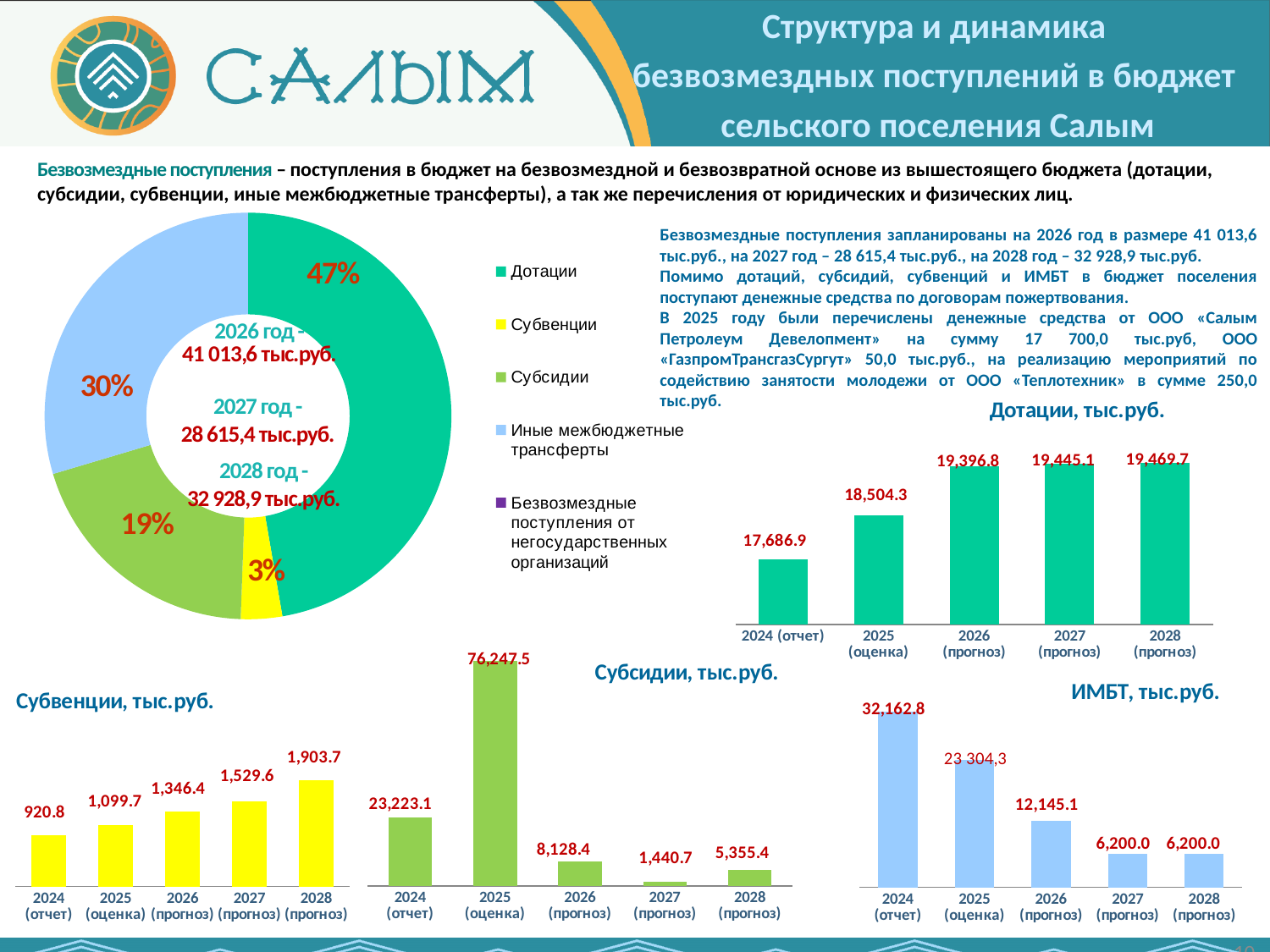
In the chart titled 'Субсидии, тыс.руб.', which year has the highest value? 2025 (оценка) What kind of chart is the one titled 'Субсидии, тыс.руб.'? bar chart In the chart titled 'Субвенции, тыс.руб.', which year has the highest value? 2028 (прогноз) In the chart titled 'Дотации, тыс.руб.', do the values rise or fall from 2024 to 2028? rise In the chart titled 'ИМБТ, тыс.руб.', do the values rise or fall from 2024 to 2028? fall In the chart titled 'Дотации, тыс.руб.', what is the value for 2025 (оценка)? 18,504.3 In the chart titled 'ИМБТ, тыс.руб.', what is the value for 2026 (прогноз)? 12,145.1 In the chart titled 'Субсидии, тыс.руб.', which year has the lowest value? 2027 (прогноз) In the chart titled 'Субвенции, тыс.руб.', what is the difference between the 2028 (прогноз) value and the 2024 (отчет) value? 982.9 How many entries does the legend of the donut chart on the left list? 5 In the donut chart on the left, what share of the total do Дотации account for? 47% How many years are shown on the x axis of the chart titled 'Дотации, тыс.руб.'? 5